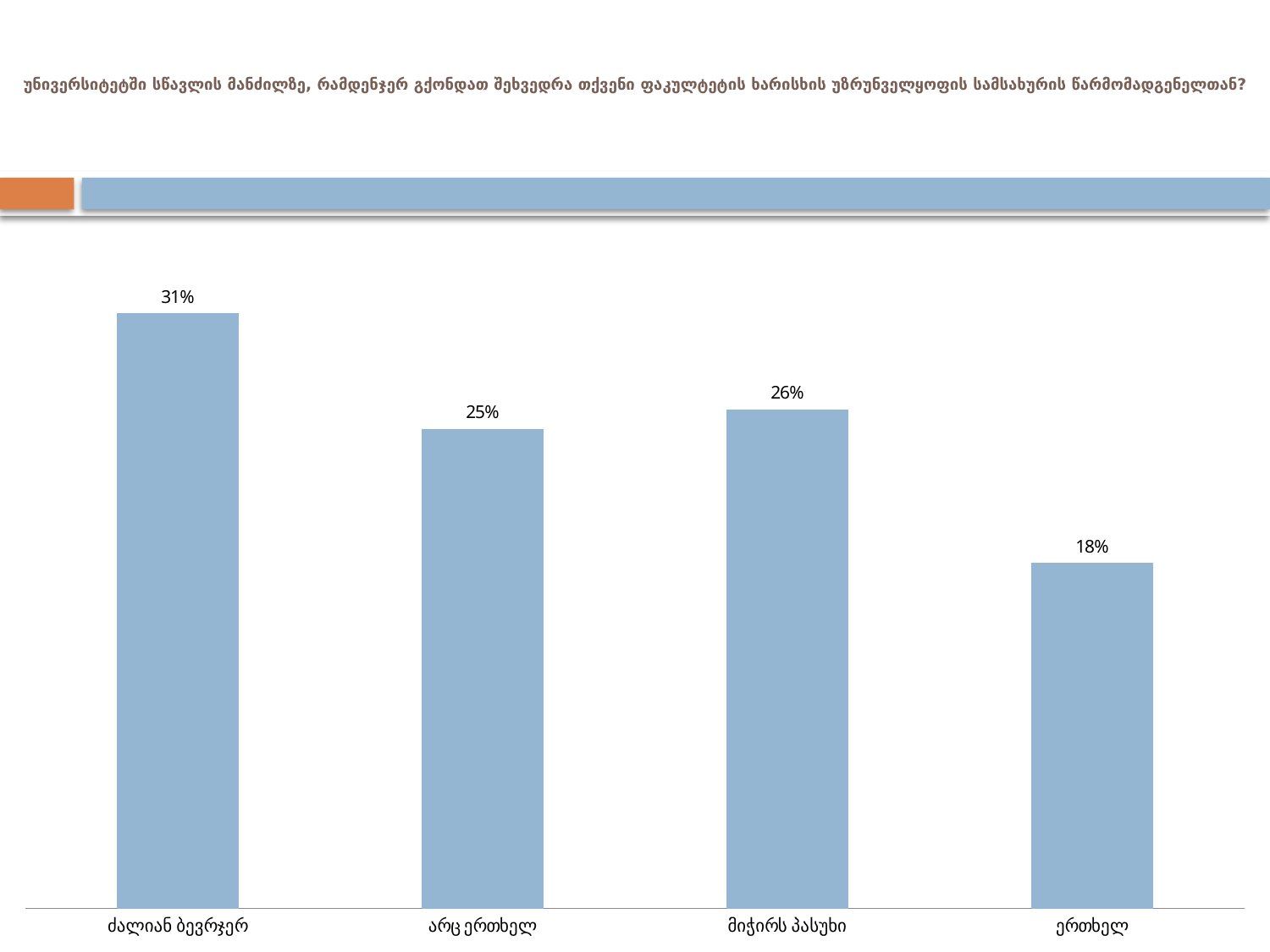
What is the value for ძალიან ბევრჯერ? 31% How many categories are shown in the chart? 4 What is the value for მიჭირს პასუხი? 26% Which category has the lowest value? ერთხელ What kind of chart is shown on the slide? Bar chart What is the difference between the values for მიჭირს პასუხი and არც ერთხელ? 1% What colour are the bars in the chart? Light blue What is the difference between the values for ძალიან ბევრჯერ and ერთხელ? 13% Which is larger, the value for ძალიან ბევრჯერ or the value for ერთხელ? ძალიან ბევრჯერ What is the value for არც ერთხელ? 25% What is the value for ერთხელ? 18% Which category has the highest value? ძალიან ბევრჯერ